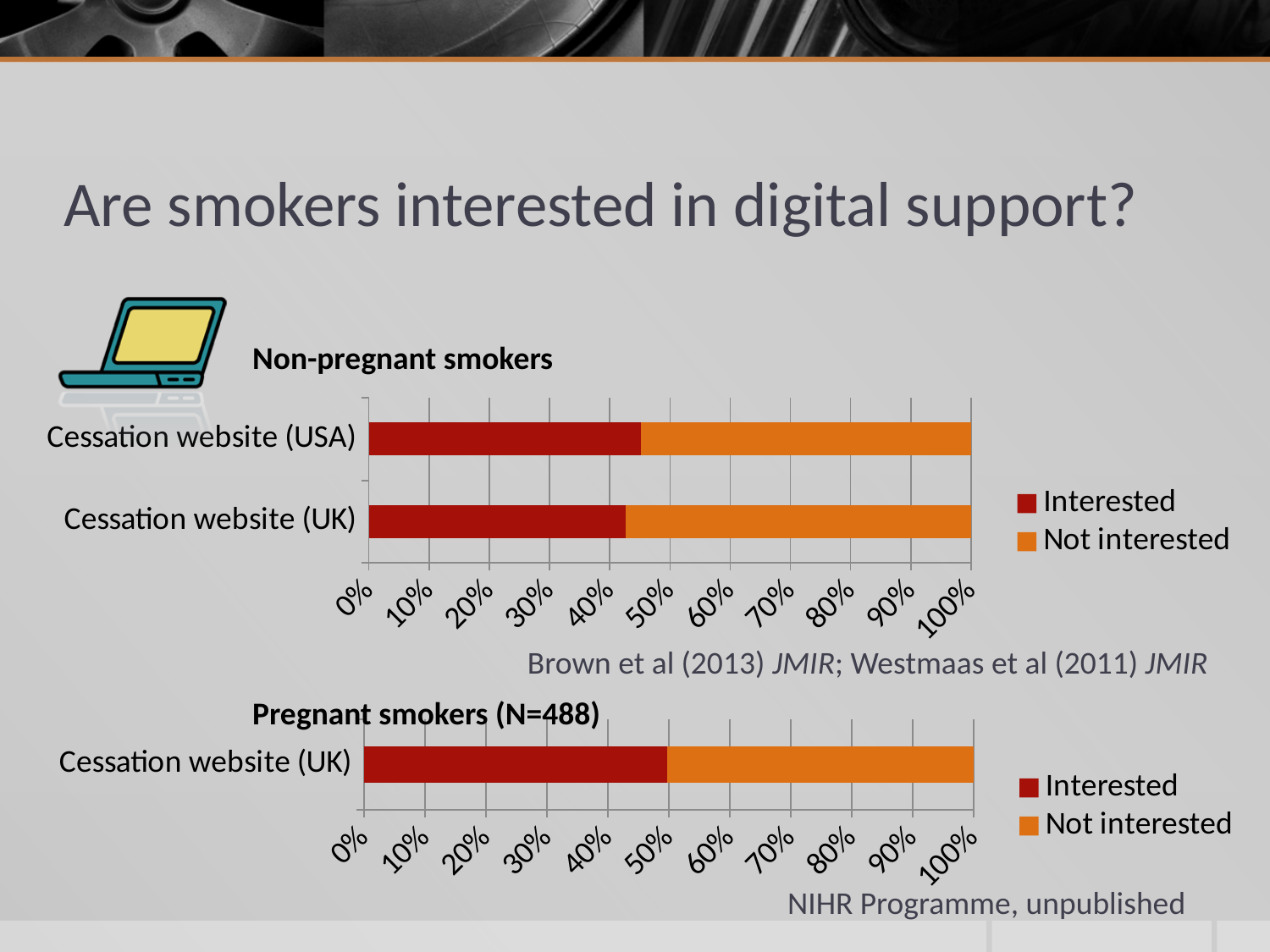
What kind of chart is the 'Non-pregnant smokers' chart? bar chart How many categories are shown in the 'Pregnant smokers (N=488)' chart? 1 How many series does the legend of the 'Non-pregnant smokers' chart list? 2 In the 'Non-pregnant smokers' chart, is the Interested value for Cessation website (USA) greater or less than 40%? greater In the 'Pregnant smokers (N=488)' chart, is the Interested value for Cessation website (UK) greater or less than 40%? greater In the 'Pregnant smokers (N=488)' chart, what is the total of the stacked bar for Cessation website (UK)? 100% In the 'Non-pregnant smokers' chart, is the Not interested value for Cessation website (USA) greater or less than 50%? greater How many categories are shown in the 'Non-pregnant smokers' chart? 2 What is the title of the bottom chart on the slide? Pregnant smokers (N=488) What are the legend entries of the 'Non-pregnant smokers' chart? Interested, Not interested